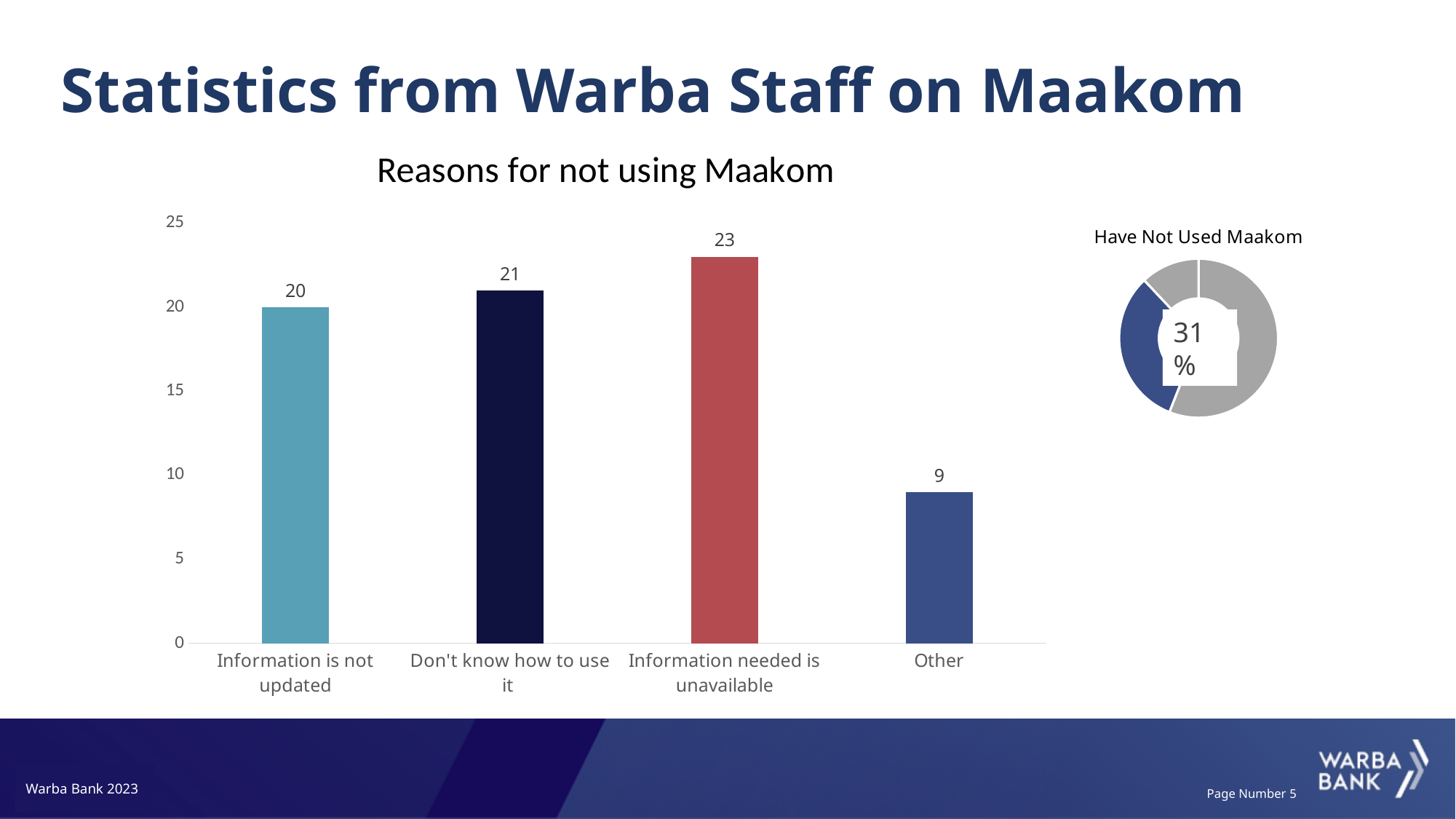
In the 'Reasons for not using Maakom' chart, what is the difference between 'Don't know how to use it' and 'Information is not updated'? 1 In the 'Reasons for not using Maakom' chart, which category has the lowest value? Other In the 'Have Not Used Maakom' chart on the right, what percentage is shown in the centre? 31% In the 'Reasons for not using Maakom' chart, what is the value for 'Information needed is unavailable'? 23 In the 'Reasons for not using Maakom' chart, which is larger: 'Information is not updated' or 'Other'? Information is not updated In the 'Reasons for not using Maakom' chart, what is the value for 'Don't know how to use it'? 21 In the 'Reasons for not using Maakom' chart, is the value for 'Other' greater or less than 10? less How many categories are shown in the 'Reasons for not using Maakom' chart? 4 In the 'Reasons for not using Maakom' chart, what is the value for 'Other'? 9 In the 'Reasons for not using Maakom' chart, which category has the highest value? Information needed is unavailable In the 'Reasons for not using Maakom' chart, what is the difference between 'Information needed is unavailable' and 'Other'? 14 What kind of chart is the 'Reasons for not using Maakom' chart? Bar chart